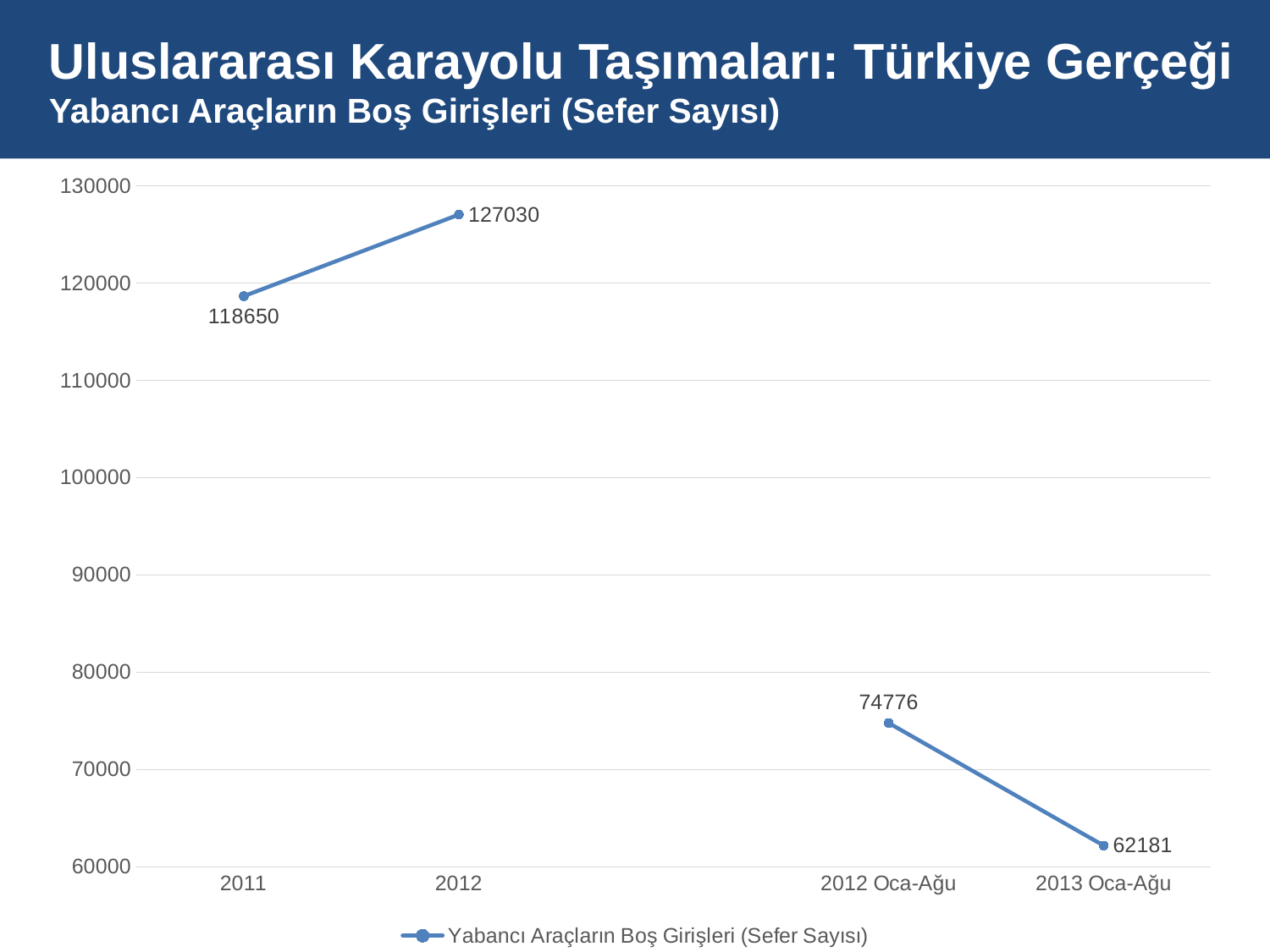
What is the value for 2011? 118650 Which category has the lowest value? 2013 Oca-Ağu What is the value for 2012 Oca-Ağu? 74776 What is the difference between the values for 2012 and 2011? 8380 Which category has the highest value? 2012 What is the value for 2013 Oca-Ağu? 62181 What is the legend entry for the plotted series? Yabancı Araçların Boş Girişleri (Sefer Sayısı) What is the value for 2012? 127030 What kind of chart is shown on the slide? line chart What is the difference between the values for 2012 Oca-Ağu and 2013 Oca-Ağu? 12595 How many data points are plotted on the chart? 4 Which is larger, the value for 2011 or the value for 2012 Oca-Ağu? 2011